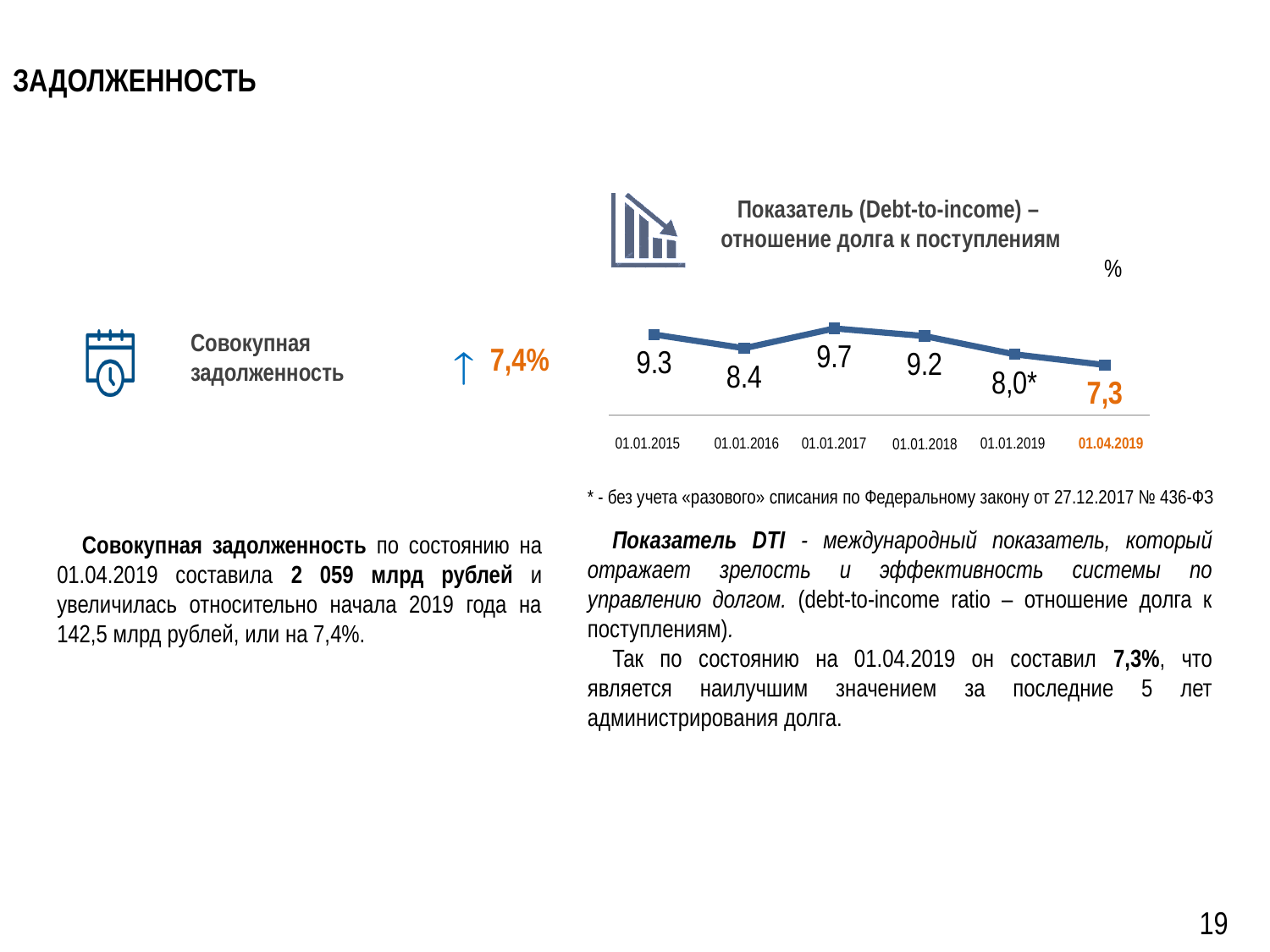
What is the DTI value shown for 01.04.2019? 7,3 What unit is indicated for the values on the DTI chart? % Which date has the highest DTI value on the chart? 01.01.2017 How many data points are plotted on the DTI chart? 6 What is the DTI value shown for 01.01.2019? 8,0 Which date has the lowest DTI value on the chart? 01.04.2019 What kind of chart is used to show the DTI indicator? line chart Which is larger, the DTI value for 01.01.2016 or for 01.01.2018? 01.01.2018 What is the DTI value shown for 01.01.2015? 9.3 What is the difference between the DTI values for 01.01.2015 and 01.01.2016? 0.9 What is the difference between the DTI values for 01.01.2017 and 01.01.2018? 0.5 What is the DTI value shown for 01.01.2017? 9.7